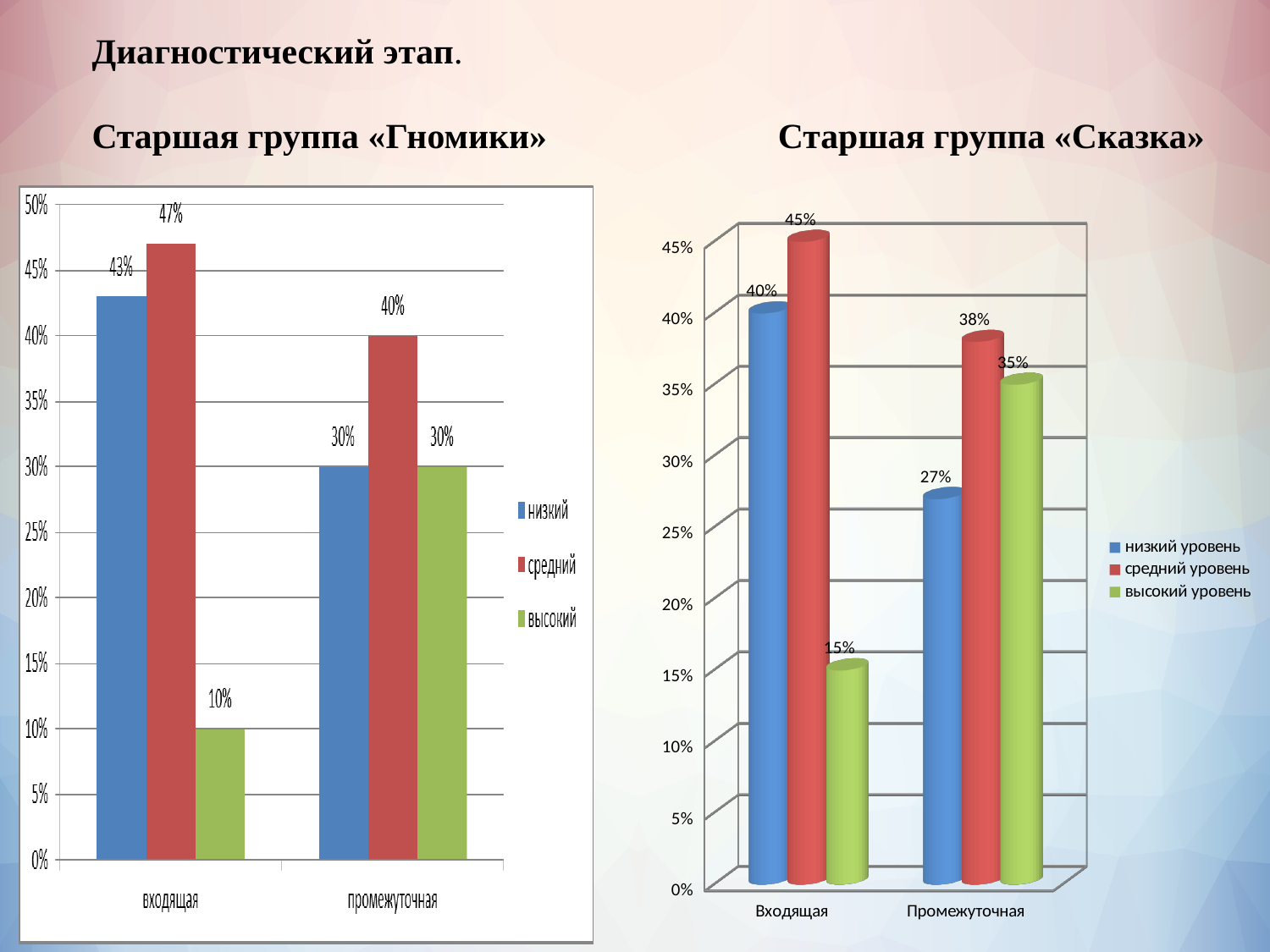
In the «Сказка» chart, what is the value of высокий уровень for Входящая? 15% In the «Сказка» chart, what is the value of низкий уровень for Промежуточная? 27% In the «Гномики» chart, what is the value of средний for входящая? 47% In the «Сказка» chart, what is the difference between средний уровень for Входящая and средний уровень for Промежуточная? 7% In the «Сказка» chart, which series has the highest value for Входящая? средний уровень What kind of chart is the «Сказка» chart? bar chart In the «Сказка» chart, which is larger: средний уровень for Промежуточная or высокий уровень for Промежуточная? средний уровень for Промежуточная In the «Гномики» chart, what is the value of высокий for промежуточная? 30% In the «Гномики» chart, how many series does the legend list? 3 In the «Гномики» chart, what is the difference between низкий for входящая and низкий for промежуточная? 13% In the «Гномики» chart, does the value of высокий rise or fall from входящая to промежуточная? rise In the «Гномики» chart, which series has the lowest value for входящая? высокий